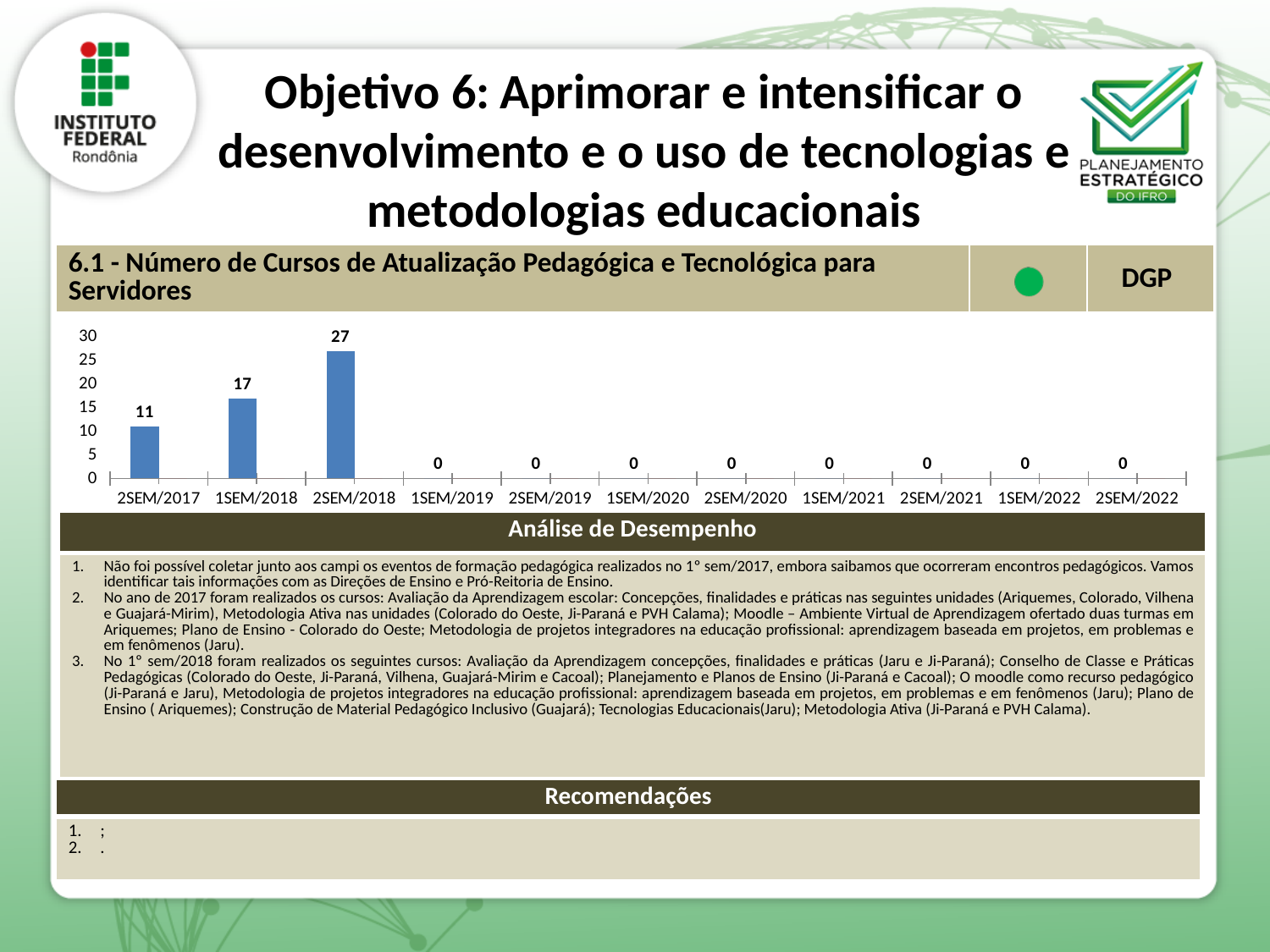
What is the difference between the values for 2SEM/2018 and 1SEM/2018? 10 What kind of chart is shown? bar chart What is the value for 2SEM/2017? 11 What is the value for 1SEM/2019? 0 What is the value for 1SEM/2018? 17 What is the value for 2SEM/2018? 27 How many categories are shown on the x axis? 11 Is the value for 2SEM/2018 greater or less than 25? greater Which is larger, the value for 2SEM/2017 or the value for 1SEM/2018? 1SEM/2018 Which category has the highest value? 2SEM/2018 What is the difference between the values for 1SEM/2018 and 2SEM/2017? 6 How many categories have a value of 0? 8